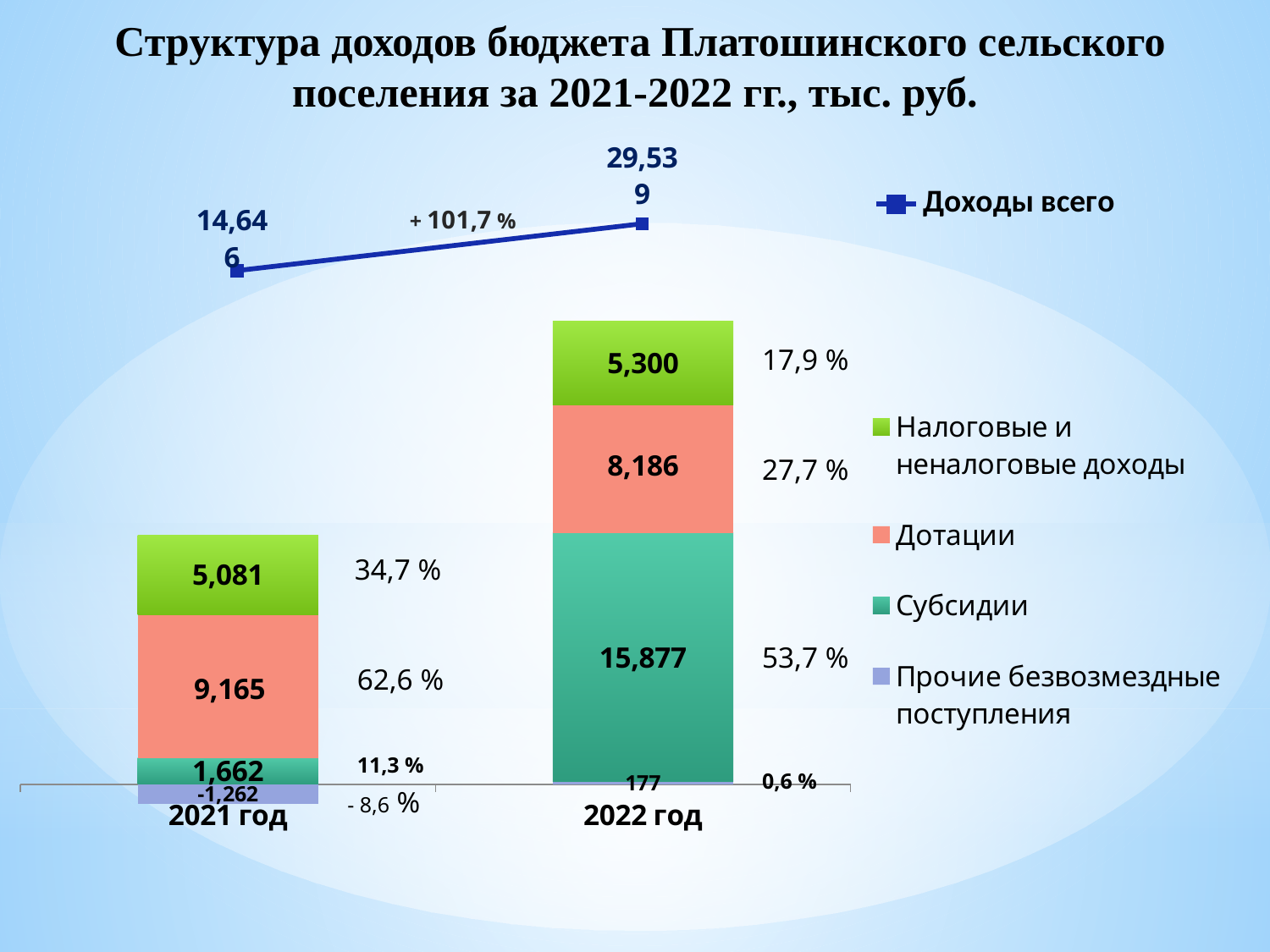
How many series does the legend list? 5 Which segment is the largest in the 2022 год bar? Субсидии What is the value of Прочие безвозмездные поступления for 2021 год? -1,262 What percentage change in Доходы всего is shown between 2021 год and 2022 год? + 101,7 % Which segment is the largest in the 2021 год bar? Дотации What is the value of Налоговые и неналоговые доходы for 2022 год? 5,300 What is the value of Дотации for 2021 год? 9,165 What is the value of Доходы всего for 2021 год? 14,646 What is the value of Доходы всего for 2022 год? 29,539 What is the value of Субсидии for 2022 год? 15,877 Which is larger: Дотации in 2021 год or Дотации in 2022 год? Дотации in 2021 год What is the difference between Субсидии in 2022 год and Субсидии in 2021 год? 14,215